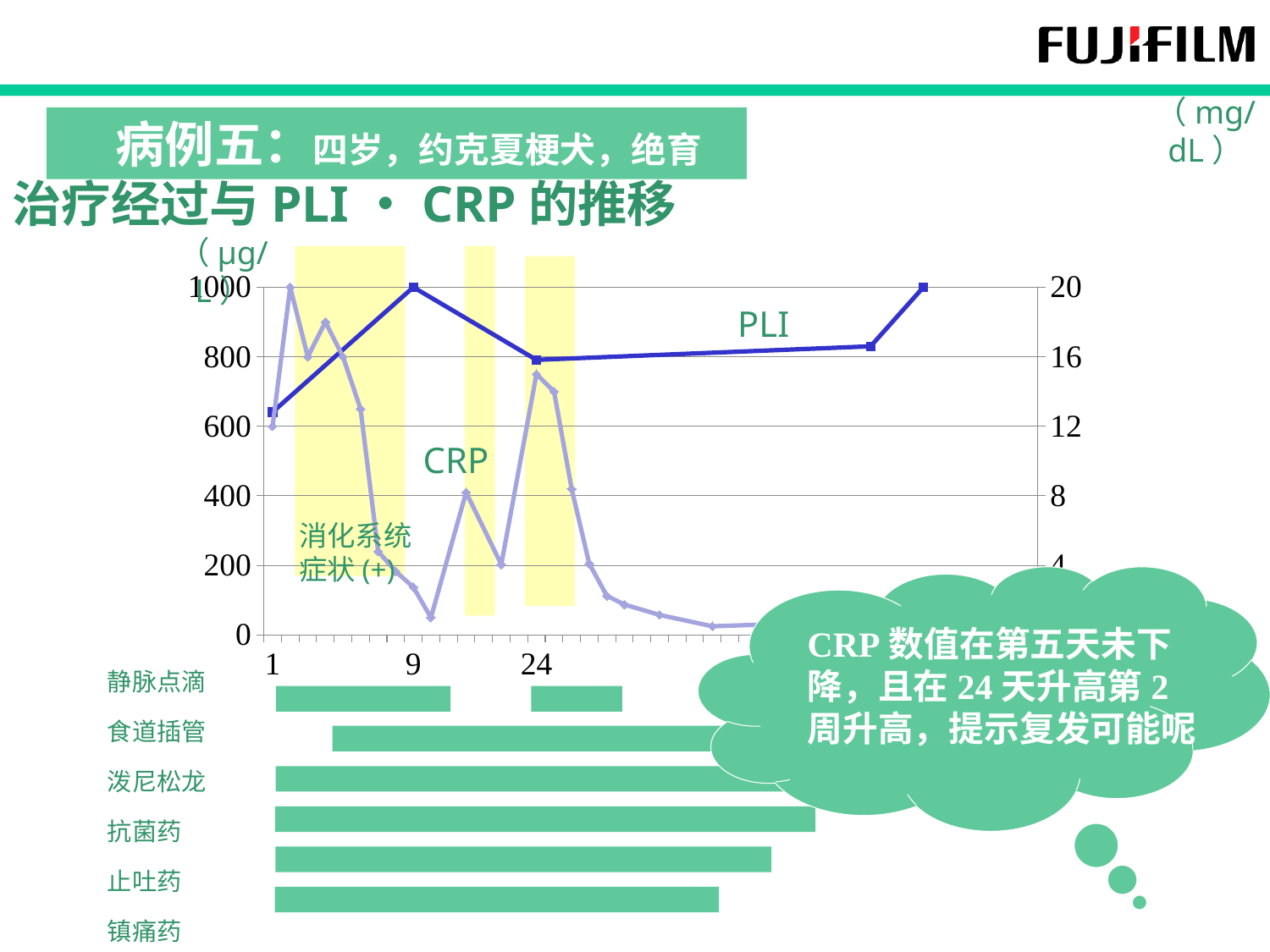
How many treatment rows are listed below the chart? 6 What are the names of the two series labelled on the chart? PLI and CRP Is the PLI value at day 1 greater or less than 800 on the left axis? less Is the PLI value at day 24 greater or less than 600 on the left axis? greater Does the PLI line rise or fall between day 9 and day 24? fall What type of chart is shown on the slide? line chart How many data series are plotted in the chart? 2 Is the highest CRP value greater or less than 16 on the right axis? greater Does the PLI line rise or fall after day 24? rise What is the PLI value at day 9 on the left axis? 1000 What unit is shown on the right-hand axis of the chart? mg/dL Which is higher, the PLI value at day 9 or the PLI value at day 24? day 9